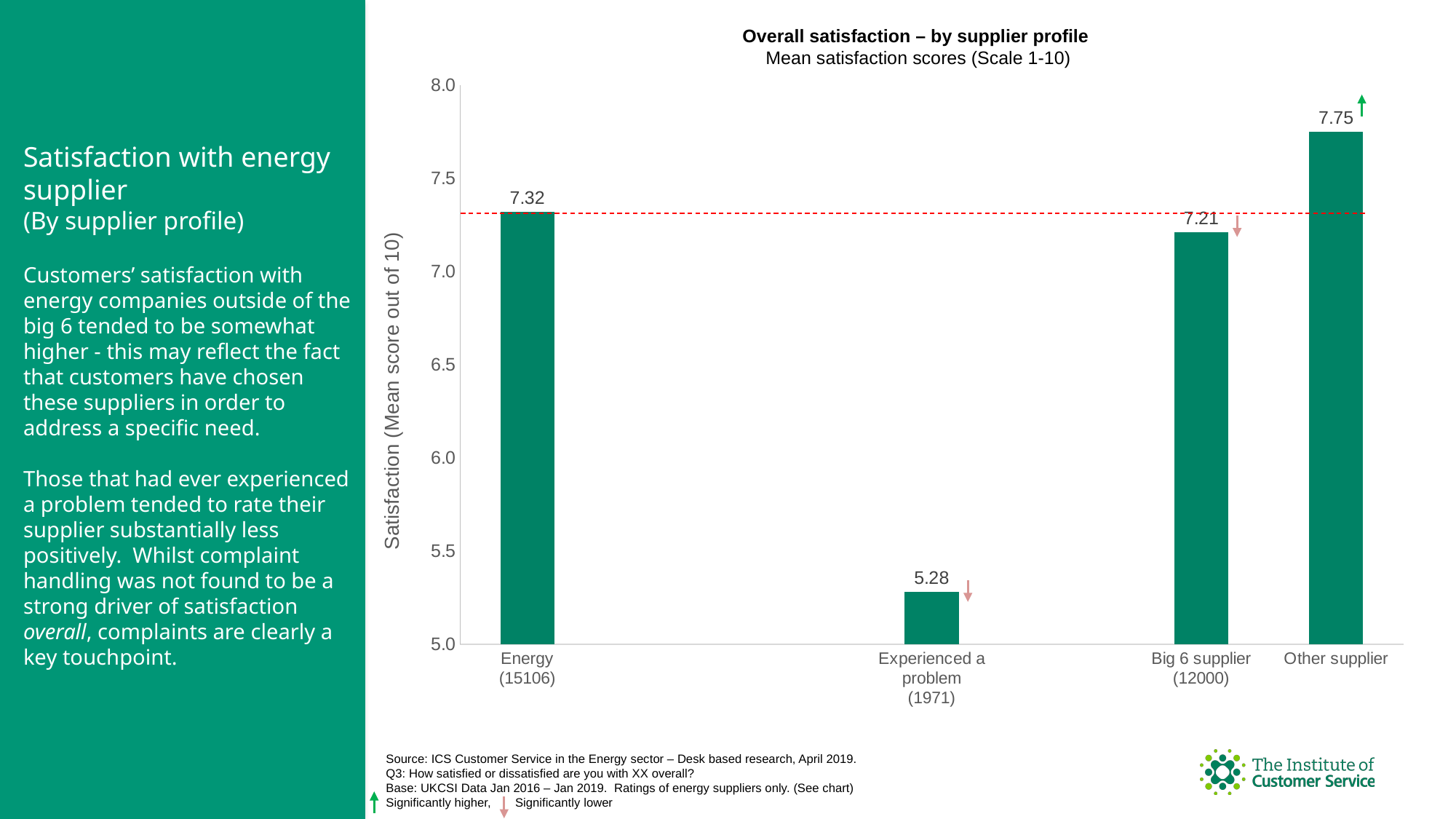
What is the mean satisfaction score for those who Experienced a problem (1971)? 5.28 Which category has the lowest mean satisfaction score? Experienced a problem (1971) What type of chart is shown on the slide? Bar chart Which category has the highest mean satisfaction score? Other supplier What is the mean satisfaction score for Big 6 supplier (12000)? 7.21 What is the mean satisfaction score for Other supplier? 7.75 Is the value for Experienced a problem greater or less than 5.5? less What is the difference between the mean satisfaction scores for Other supplier and Big 6 supplier? 0.54 Which has a higher mean satisfaction score, Big 6 supplier or Other supplier? Other supplier What is the difference between the mean satisfaction scores for Energy and Experienced a problem? 2.04 What is the mean satisfaction score for Energy (15106)? 7.32 How many categories are shown on the chart? 4